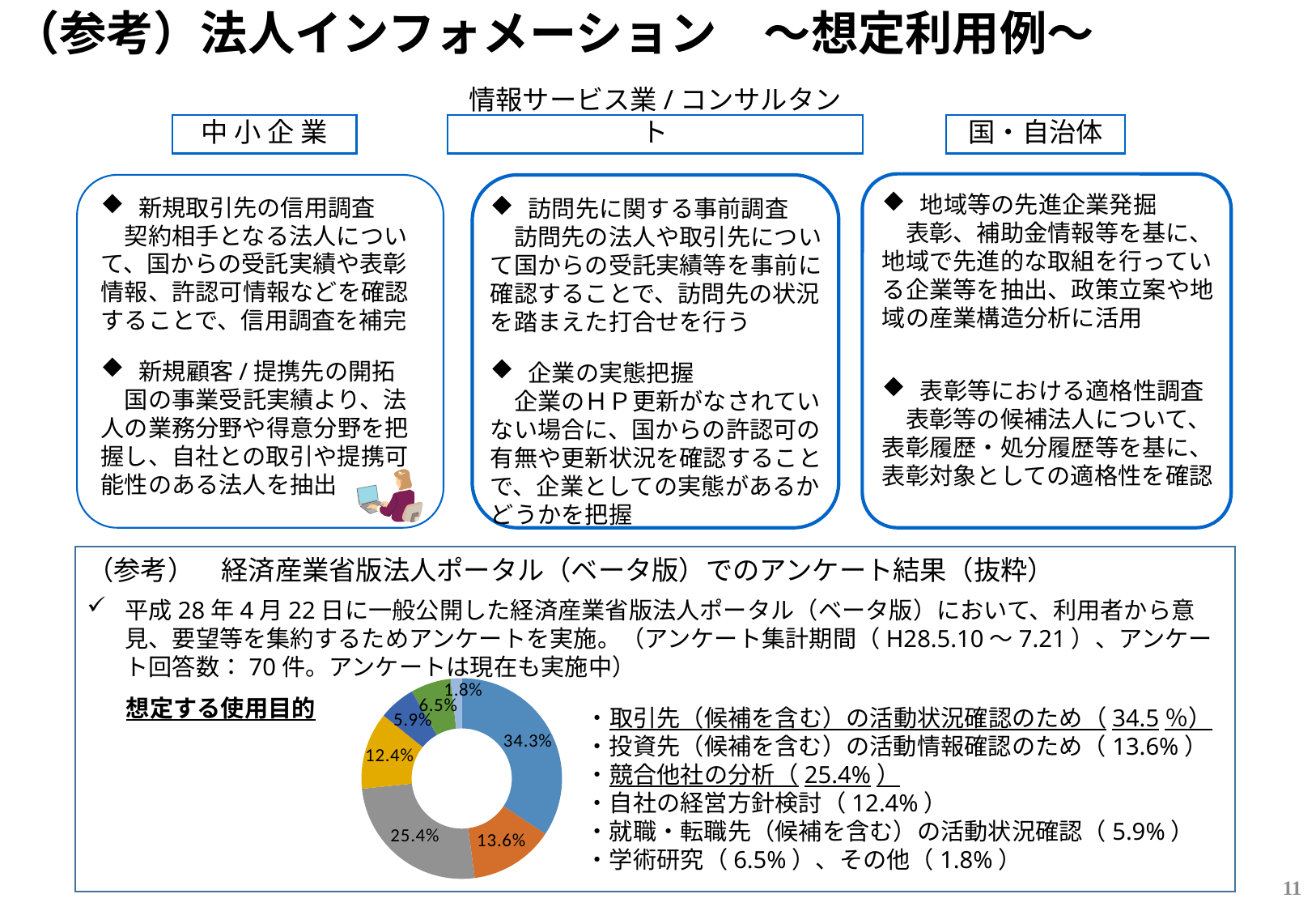
What is the heading written next to the pie chart at the bottom of the slide? 想定する使用目的 In the 想定する使用目的 pie chart, which is larger: 競合他社の分析 or 投資先（候補を含む）の活動情報確認のため? 競合他社の分析 In the 想定する使用目的 pie chart, what percentage is shown for 学術研究? 6.5% In the 想定する使用目的 pie chart, what percentage is shown for その他? 1.8% What kind of chart is shown at the bottom of the slide under 想定する使用目的? pie chart (donut) Which purpose has the smallest slice in the 想定する使用目的 pie chart? その他 In the 想定する使用目的 pie chart, what percentage is shown for 競合他社の分析? 25.4% In the 想定する使用目的 pie chart, what is the difference in percentage points between 競合他社の分析 (25.4%) and 投資先（候補を含む）の活動情報確認のため (13.6%)? 11.8 percentage points Which purpose has the largest slice in the 想定する使用目的 pie chart? 取引先（候補を含む）の活動状況確認のため In the 想定する使用目的 pie chart, what percentage is shown for 自社の経営方針検討? 12.4% How many slices does the 想定する使用目的 pie chart have? 7 In the 想定する使用目的 pie chart, what percentage is shown for 投資先（候補を含む）の活動情報確認のため? 13.6%